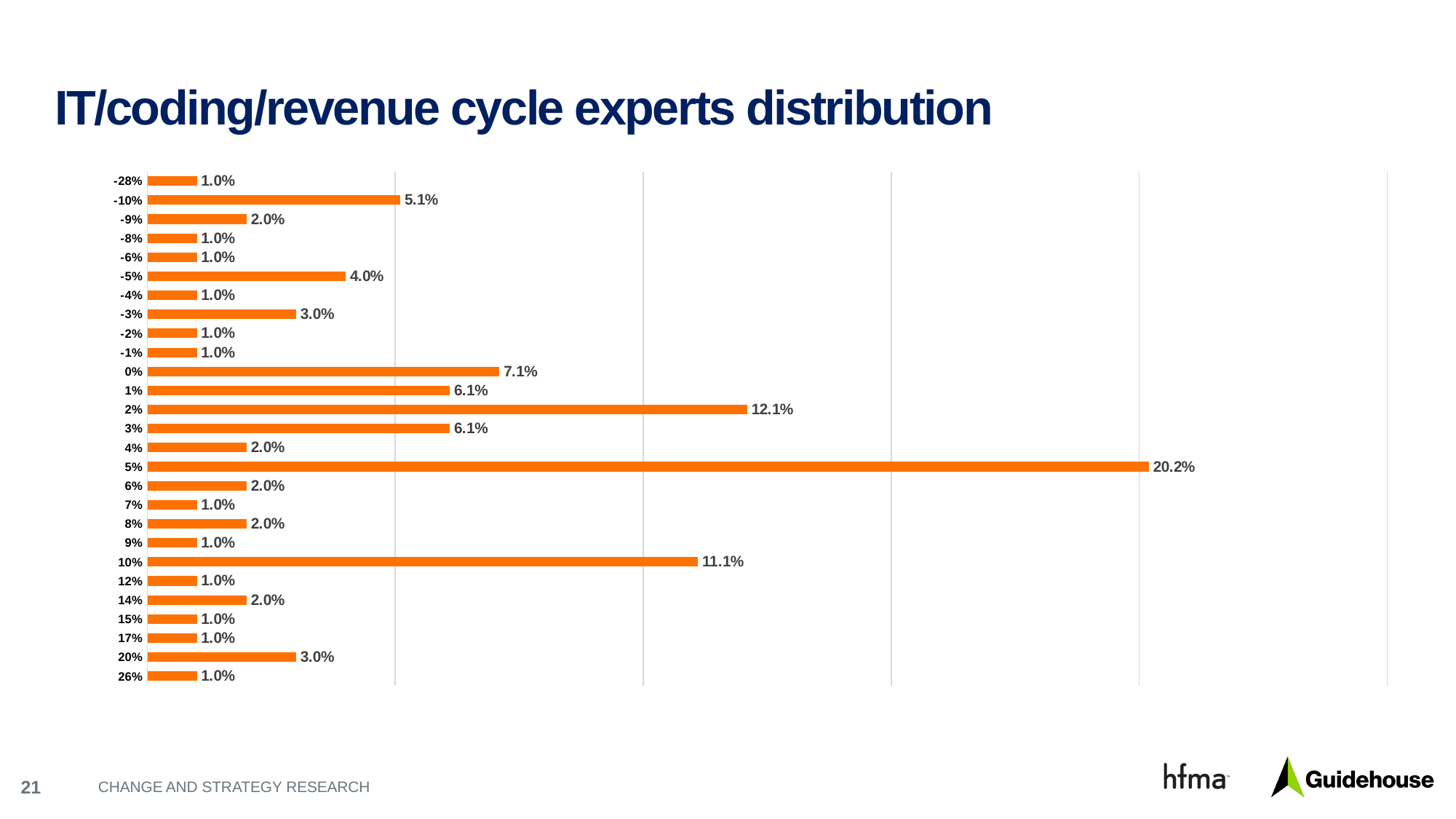
What is the difference between the values for the 5% and 2% categories? 8.1% What kind of chart is shown on the slide? bar chart What is the title of the slide? IT/coding/revenue cycle experts distribution Which is larger, the value for the 2% category or the value for the 10% category? 2% What is the value for the 0% category? 7.1% What is the value for the 2% category? 12.1% What is the value for the -10% category? 5.1% What is the value for the 5% category? 20.2% Which category has the highest value? 5% What is the value for the 10% category? 11.1% How many categories are shown on the chart? 27 What is the lowest value shown on the chart? 1.0%